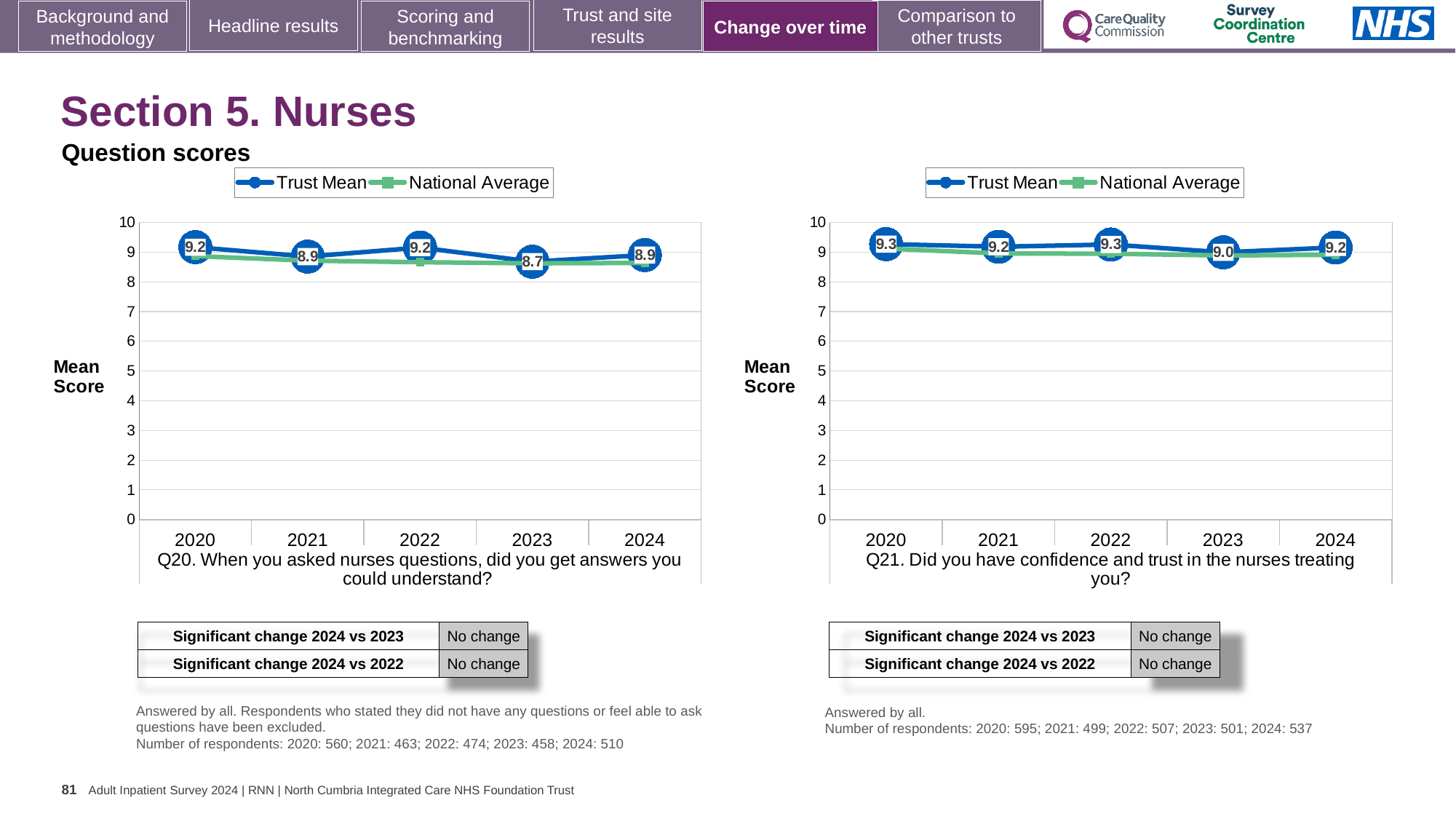
In the Q20 chart on the left, which year has the higher Trust Mean score, 2020 or 2023? 2020 In the Q21 chart on the right, is the National Average value for 2020 greater or less than 8? greater In the Q20 chart on the left, what is the Trust Mean score for 2023? 8.7 What kind of chart is the Q20 chart on the left? Line chart In the Q21 chart on the right, does the Trust Mean score rise or fall from 2022 to 2023? Fall In the Q21 chart on the right, which year has the lowest Trust Mean score? 2023 How many series does the legend of the Q21 chart on the right list? 2 How many years are plotted on the x axis of the Q20 chart on the left? 5 In the Q20 chart on the left, which year has the lowest Trust Mean score? 2023 In the Q20 chart on the left, what is the difference between the Trust Mean scores for 2022 and 2023? 0.5 In the Q21 chart on the right, what is the difference between the Trust Mean scores for 2020 and 2023? 0.3 In the Q21 chart on the right, what is the Trust Mean score for 2024? 9.2